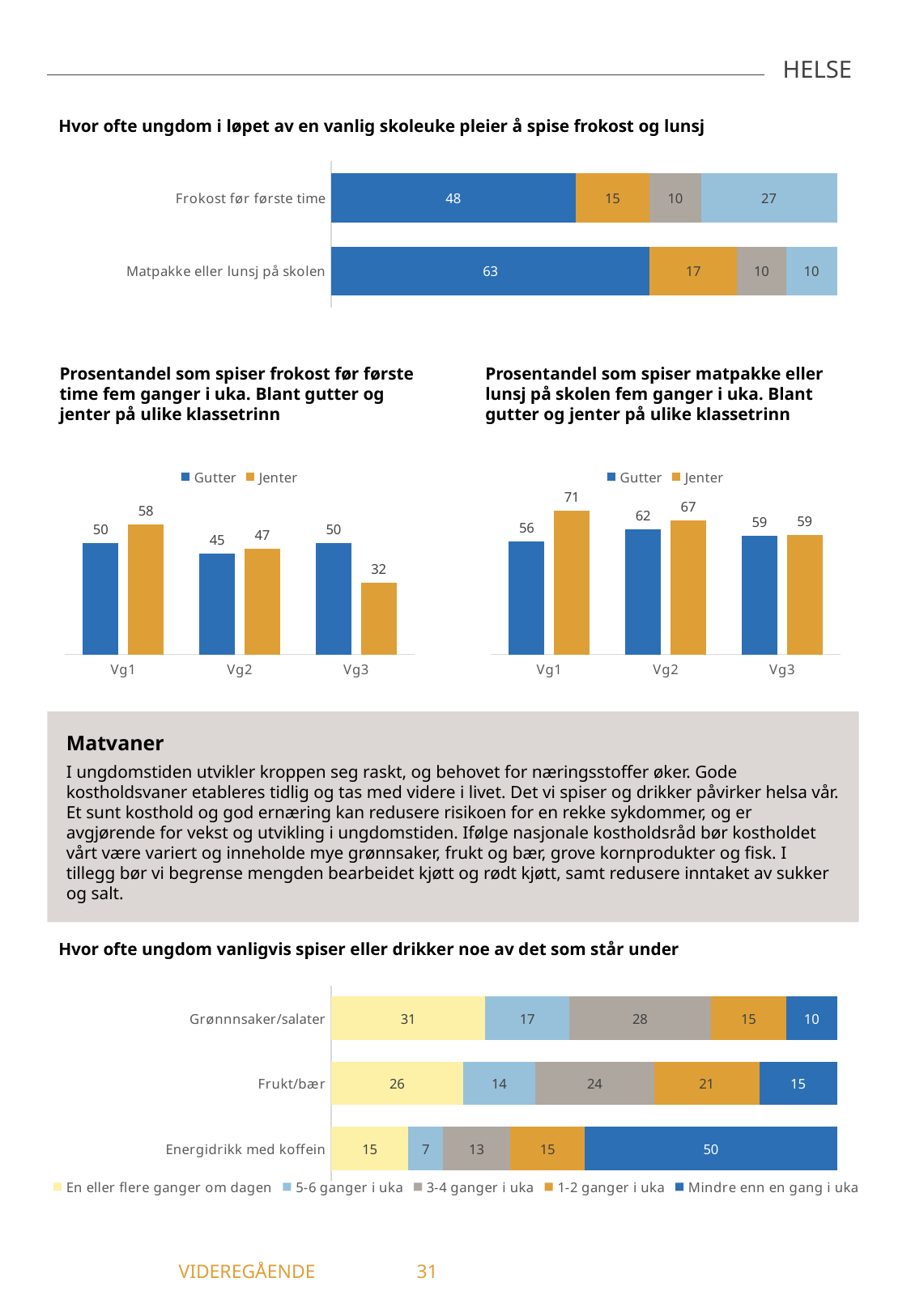
In the top chart 'Hvor ofte ungdom i løpet av en vanlig skoleuke pleier å spise frokost og lunsj', what is the value of the last (light blue) segment for 'Frokost før første time'? 27 In the chart 'Prosentandel som spiser matpakke eller lunsj på skolen fem ganger i uka', which is larger at Vg2, Gutter or Jenter? Jenter In the chart 'Prosentandel som spiser matpakke eller lunsj på skolen fem ganger i uka', how many series does the legend list? 2 In the chart 'Prosentandel som spiser frokost før første time fem ganger i uka', what is the difference between Gutter and Jenter at Vg3? 18 In the chart 'Prosentandel som spiser frokost før første time fem ganger i uka', which class level has the highest value for Jenter? Vg1 In the bottom chart 'Hvor ofte ungdom vanligvis spiser eller drikker noe av det som står under', what is the value for 'En eller flere ganger om dagen' for 'Frukt/bær'? 26 What kind of chart is the bottom chart 'Hvor ofte ungdom vanligvis spiser eller drikker noe av det som står under'? Stacked bar chart In the chart 'Prosentandel som spiser matpakke eller lunsj på skolen fem ganger i uka', what is the value for Jenter at Vg1? 71 In the top chart 'Hvor ofte ungdom i løpet av en vanlig skoleuke pleier å spise frokost og lunsj', what is the value of the first (dark blue) segment for 'Matpakke eller lunsj på skolen'? 63 In the chart 'Prosentandel som spiser frokost før første time fem ganger i uka', what is the value for Jenter at Vg3? 32 In the top chart 'Hvor ofte ungdom i løpet av en vanlig skoleuke pleier å spise frokost og lunsj', how many categories are shown? 2 In the bottom chart 'Hvor ofte ungdom vanligvis spiser eller drikker noe av det som står under', what is the value for 'Mindre enn en gang i uka' for 'Energidrikk med koffein'? 50